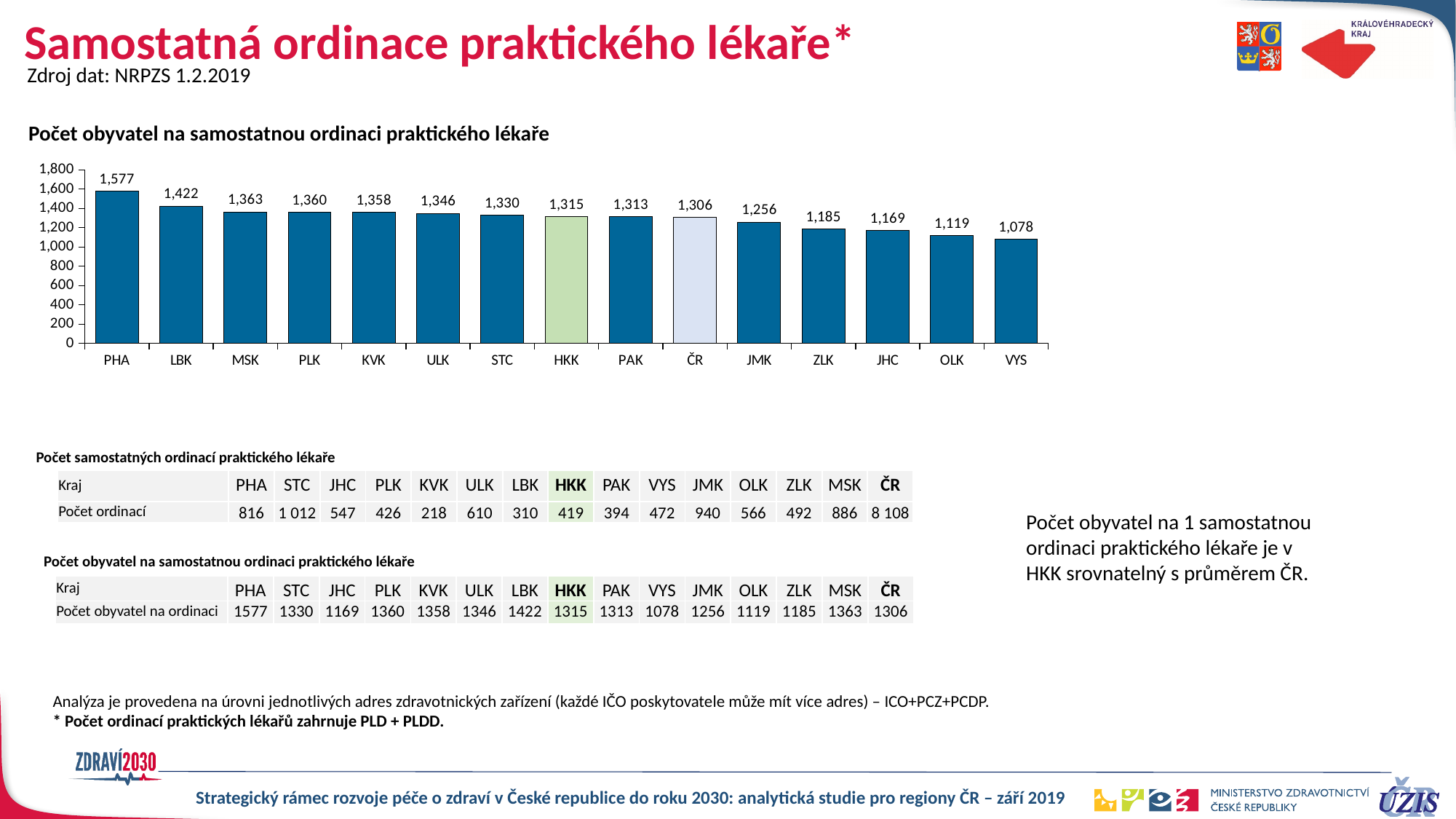
What is the difference between the values for HKK and ČR? 9 Which category has the highest value in the chart? PHA What is the value for LBK in the chart? 1,422 What is the difference between the values for PHA and VYS? 499 Which category has the lowest value in the chart? VYS What is the value for ČR in the chart? 1,306 Which has a larger value, LBK or MSK? LBK Is the value for JMK greater or less than 1,200? greater How many categories are shown on the x axis of the chart? 15 What is the value for HKK in the chart? 1,315 What kind of chart is shown on the slide? bar chart Do the values rise or fall from left to right along the x axis? fall